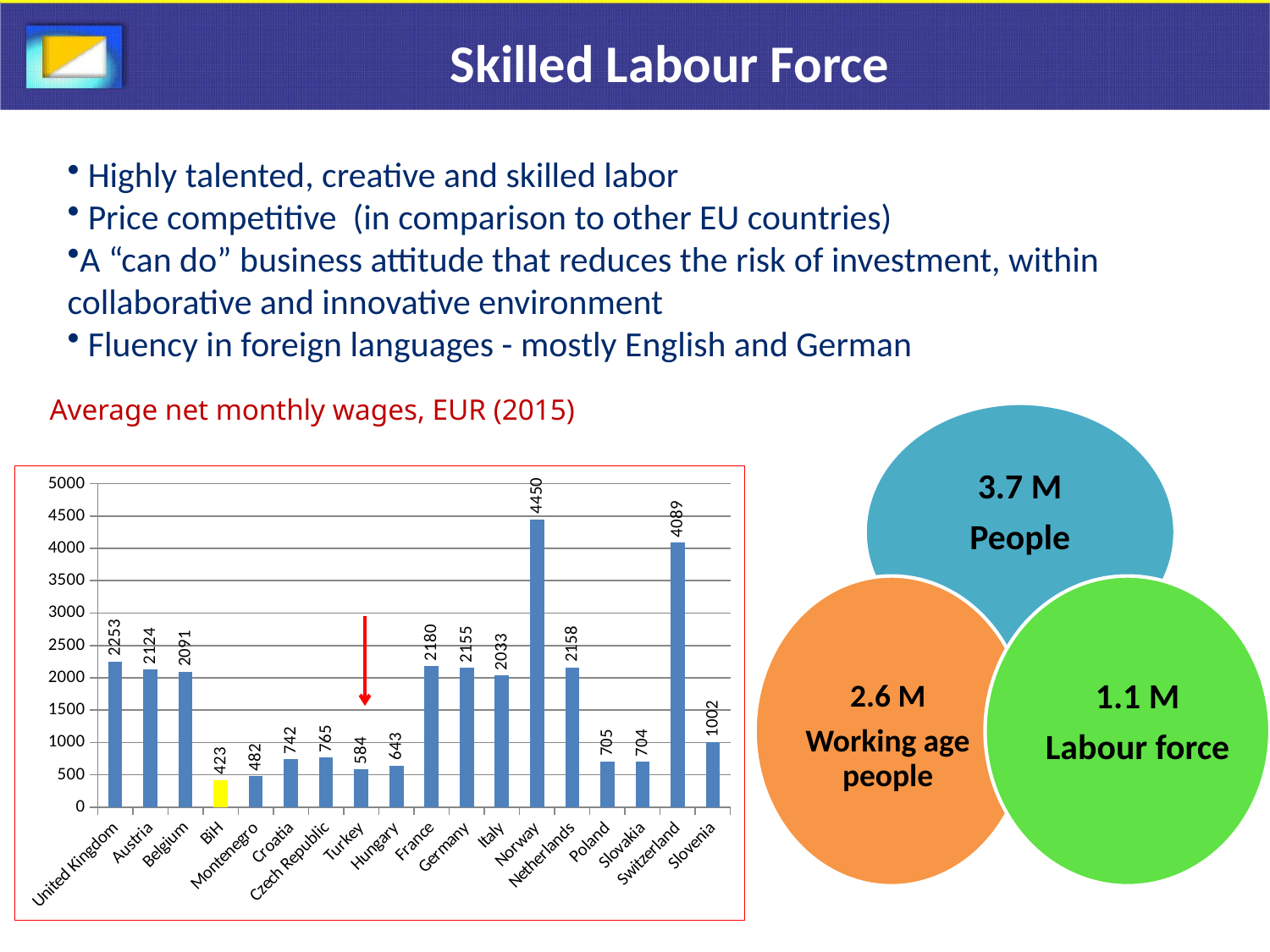
What is the average net monthly wage shown for Norway? 4450 Which country has the highest average net monthly wage in the chart? Norway How many countries are shown in the bar chart? 18 Which has a higher average net monthly wage, Croatia or Czech Republic? Czech Republic Which country's bar is highlighted in yellow in the chart? BiH What is the difference between the average net monthly wages of Montenegro and BiH? 59 What is the difference between the average net monthly wages of Norway and Switzerland? 361 Is the value for Germany greater or less than 2000? greater What is the average net monthly wage shown for BiH? 423 Which country has the lowest average net monthly wage in the chart? BiH What is the average net monthly wage shown for Slovenia? 1002 What kind of chart is used to show average net monthly wages? bar chart